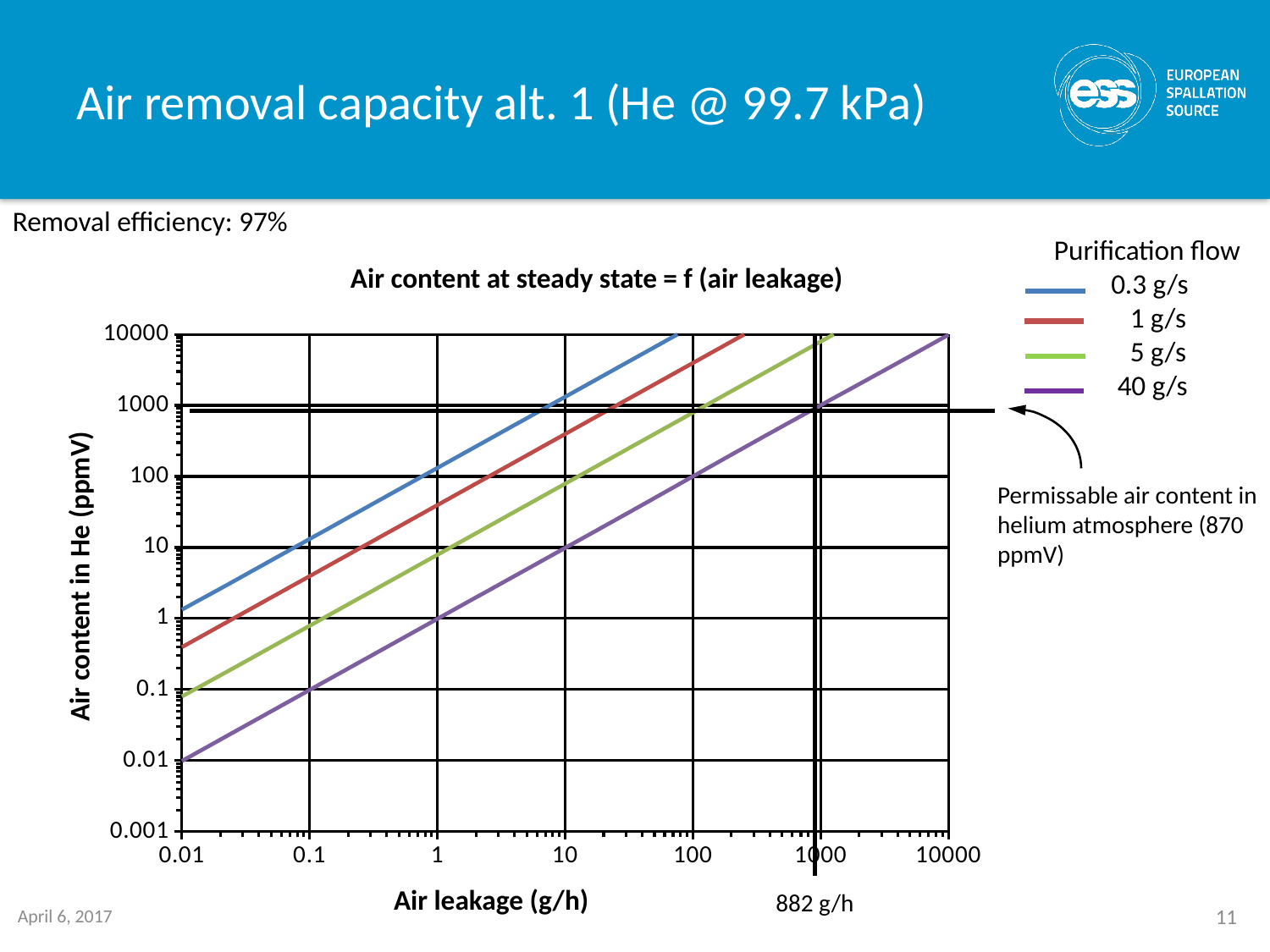
Which purification flow series gives the highest air content for any given air leakage? 0.3 g/s What is the title of the legend? Purification flow How many series does the legend list? 4 What permissible air content in the helium atmosphere is marked by the horizontal line on the chart? 870 ppmV What air leakage value is marked by the vertical line on the chart? 882 g/h At an air leakage of 10 g/h, which series shows the higher air content, 0.3 g/s or 40 g/s? 0.3 g/s Do the plotted lines rise or fall as air leakage increases along the x axis? Rise What kind of chart is shown on the slide? Line chart What is the title of the chart? Air content at steady state = f (air leakage) At an air leakage of 1 g/h, is the air content for the 0.3 g/s series greater or less than 100 ppmV? greater Which purification flow series gives the lowest air content for any given air leakage? 40 g/s At an air leakage of 1 g/h, is the air content for the 40 g/s series greater or less than 10 ppmV? less